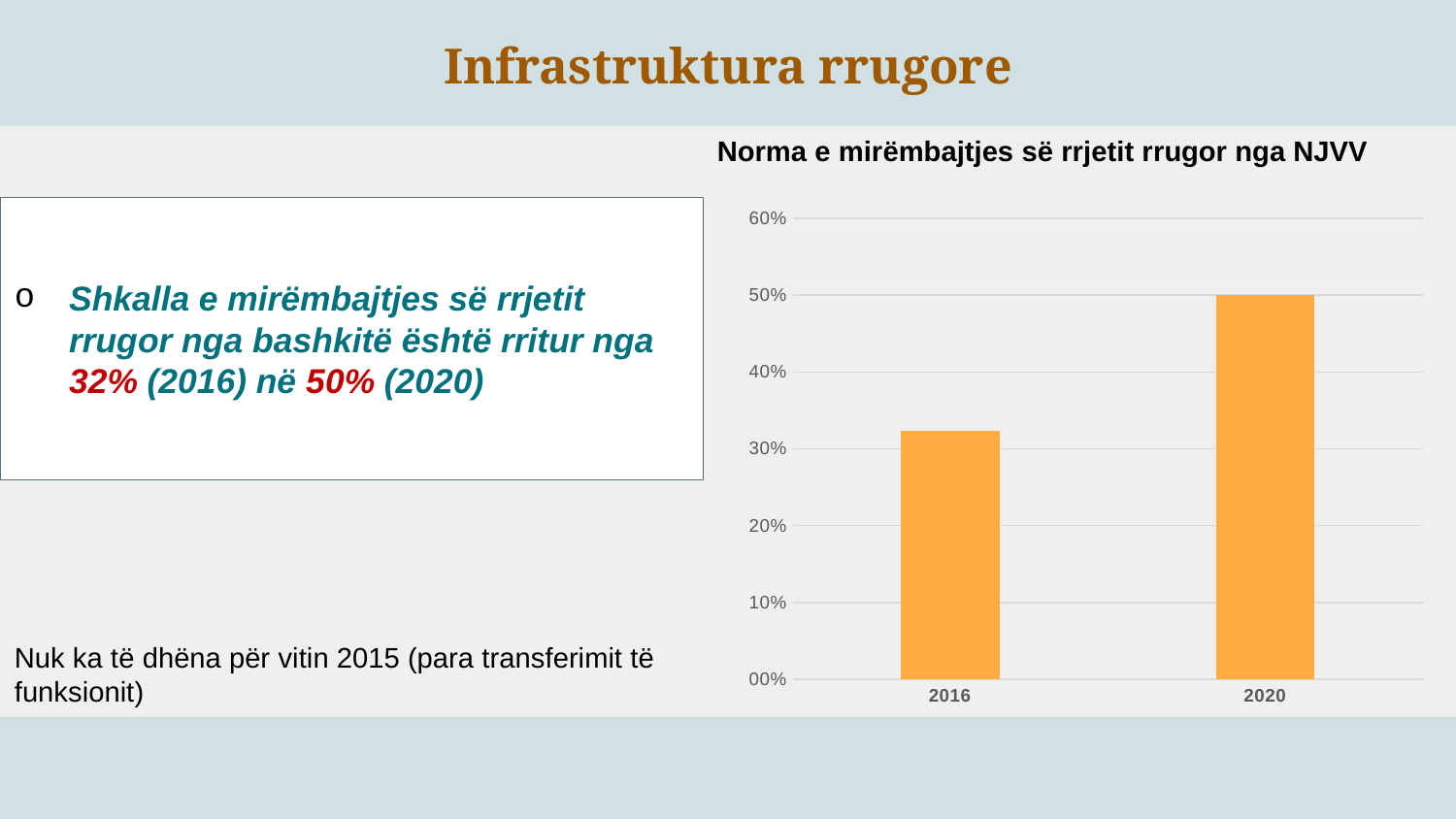
Is the value for 2016 greater or less than 30%? greater Which is larger in the chart, the value for 2016 or the value for 2020? 2020 How many categories are shown on the x axis of the chart? 2 Is the value for 2016 greater or less than 40%? less What is the value for 2020 in the chart? 50% Which year has the lowest value in the chart? 2016 Which year has the highest value in the chart? 2020 What colour are the bars in the chart? orange Is the value for 2020 greater or less than 40%? greater What is the title of the chart? Norma e mirëmbajtjes së rrjetit rrugor nga NJVV Do the values rise or fall from 2016 to 2020 in the chart? rise What type of chart is shown on the slide? bar chart